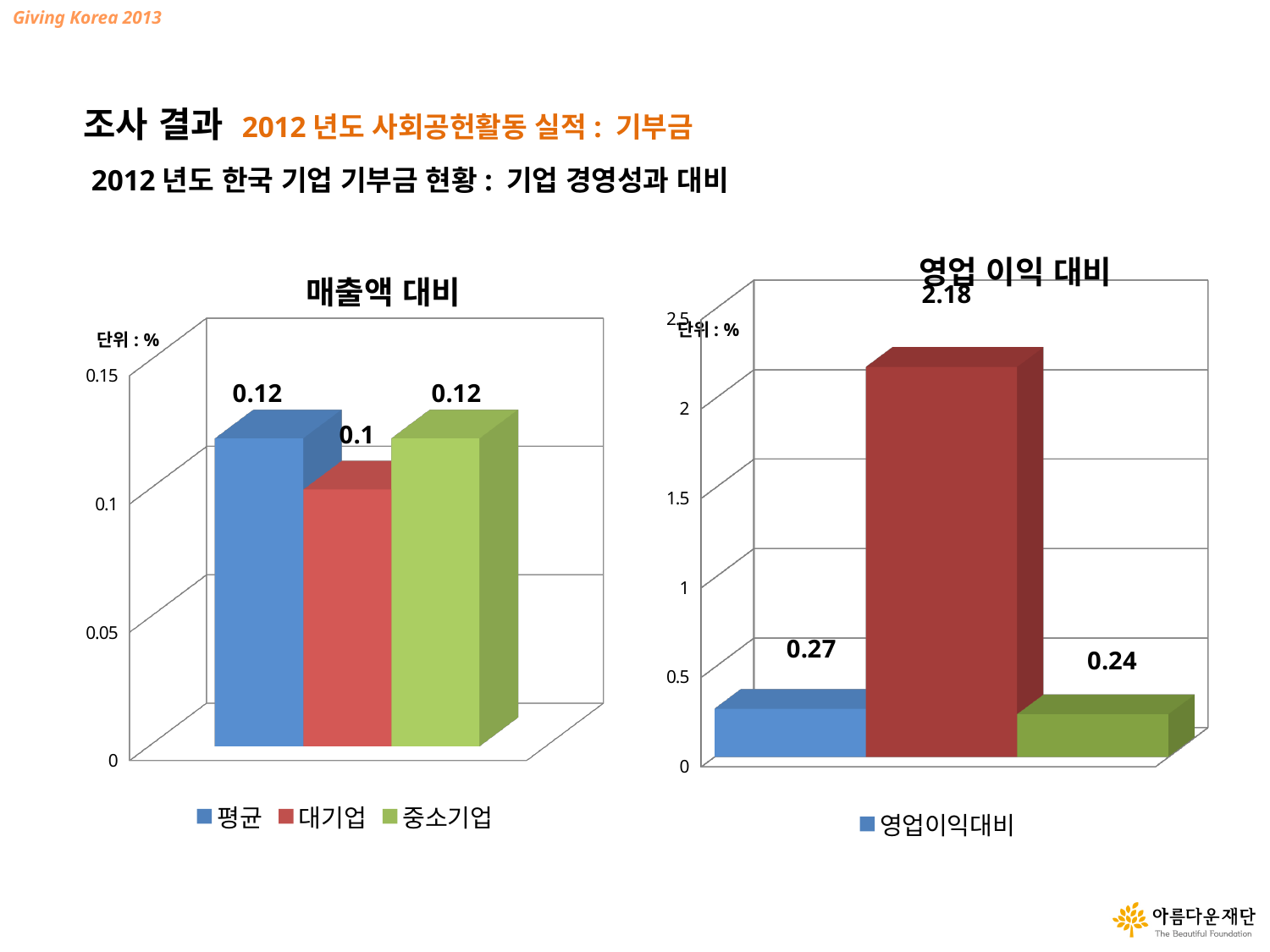
In the 매출액 대비 chart, what is the value for 평균? 0.12 In the 매출액 대비 chart, what is the value for 중소기업? 0.12 What type of chart is the 영업 이익 대비 chart? Bar chart In the 매출액 대비 chart, how many series does the legend list? 3 In the 영업 이익 대비 chart, is the value of the middle bar greater or less than 2? greater In the 매출액 대비 chart, which category has the lowest value? 대기업 In the 매출액 대비 chart, what is the value for 대기업? 0.1 In the 영업 이익 대비 chart, what is the value of the leftmost bar? 0.27 In the 영업 이익 대비 chart, what is the value of the tallest (middle) bar? 2.18 In the 영업 이익 대비 chart, what is the difference between the middle bar and the rightmost bar? 1.94 In the 매출액 대비 chart, what unit is indicated for the values? % In the 매출액 대비 chart, what is the difference between the values for 평균 and 대기업? 0.02